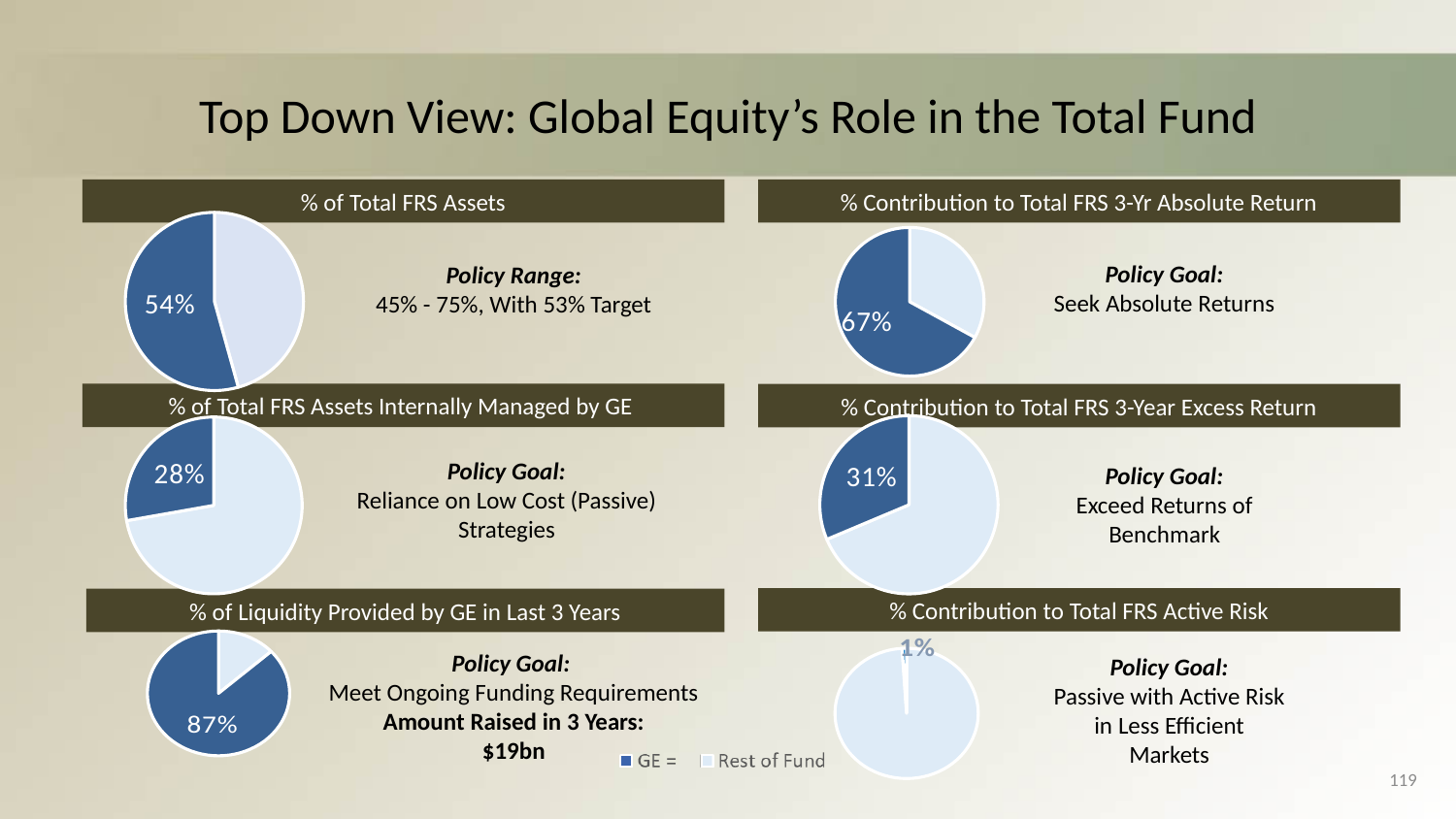
In the '% of Total FRS Assets' pie chart, what share of the pie is the 'Rest of Fund' slice? 46% In the '% Contribution to Total FRS 3-Yr Absolute Return' pie chart, what share is labelled for GE? 67% Which pie chart shows the largest GE share: '% of Liquidity Provided by GE in Last 3 Years' or '% of Total FRS Assets'? % of Liquidity Provided by GE in Last 3 Years In the '% Contribution to Total FRS 3-Year Excess Return' pie chart, what share is labelled for GE? 31% What is the difference in percentage points between the GE share in '% Contribution to Total FRS 3-Yr Absolute Return' and the GE share in '% Contribution to Total FRS 3-Year Excess Return'? 36 percentage points In the '% of Liquidity Provided by GE in Last 3 Years' pie chart, what share is labelled for GE? 87% How many entries does the legend at the bottom of the slide list? 2 In the '% of Total FRS Assets Internally Managed by GE' pie chart, what share is labelled for GE? 28% In the '% Contribution to Total FRS Active Risk' pie chart, what share is labelled for GE? 1% How many pie charts are shown on the slide? 6 In the '% of Total FRS Assets' pie chart, what share is labelled for GE? 54% What kind of chart is used for '% of Total FRS Assets'? Pie chart